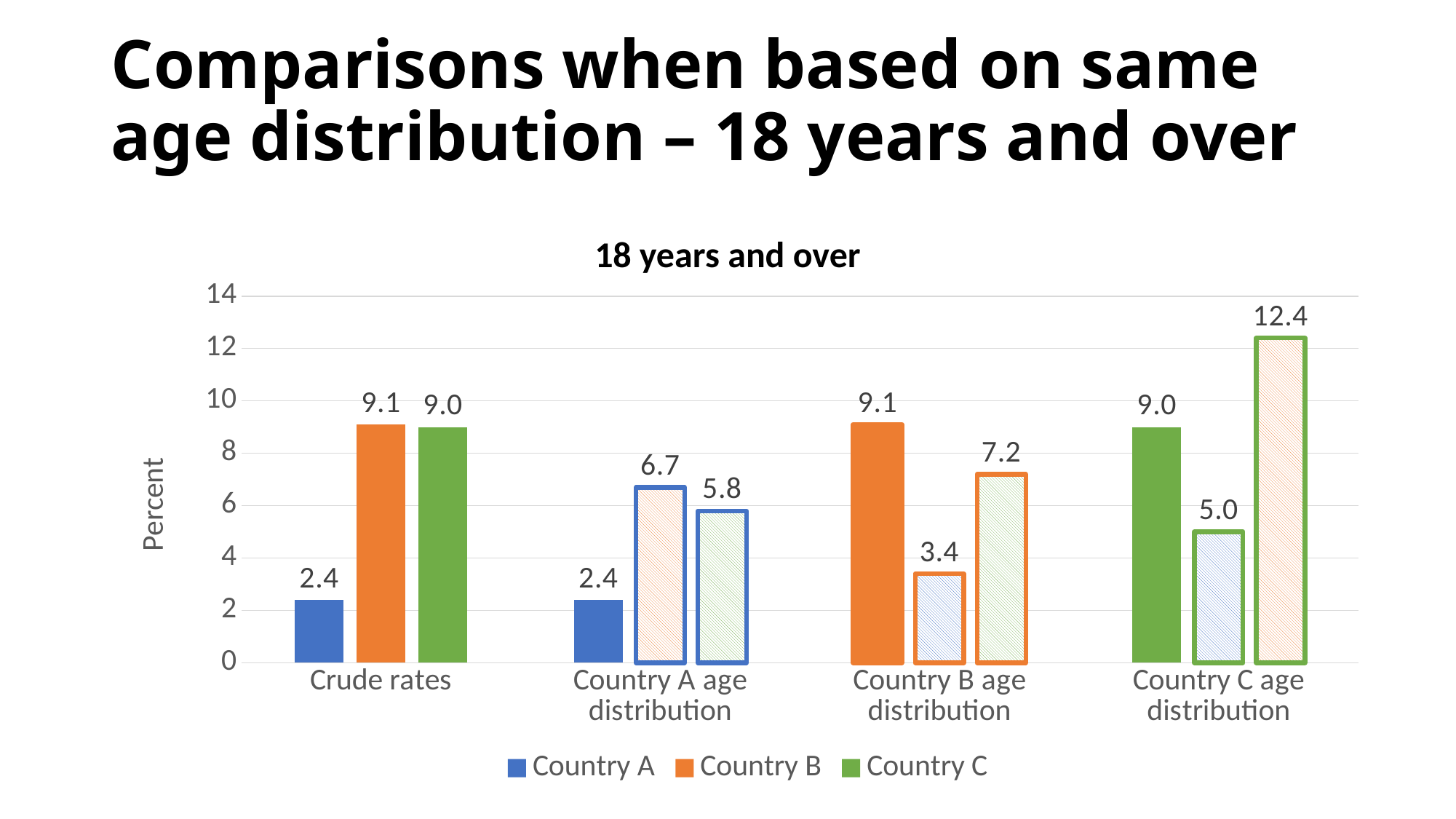
What kind of chart is shown? Bar chart How many series does the legend list? 3 How many categories are shown on the x axis? 4 Which series has the lowest value under Crude rates? Country A Which is larger under Country B age distribution: Country A or Country C? Country A What is the value for Country B under Country B age distribution? 3.4 What is the value for Country B under Crude rates? 9.1 What is the value for Country C under Country A age distribution? 5.8 What is the value for Country C under Country C age distribution? 12.4 Which series has the highest value under Country C age distribution? Country C Is the value for Country C under Country C age distribution greater or less than 12? greater What is the difference between Country B and Country C under Country A age distribution? 0.9